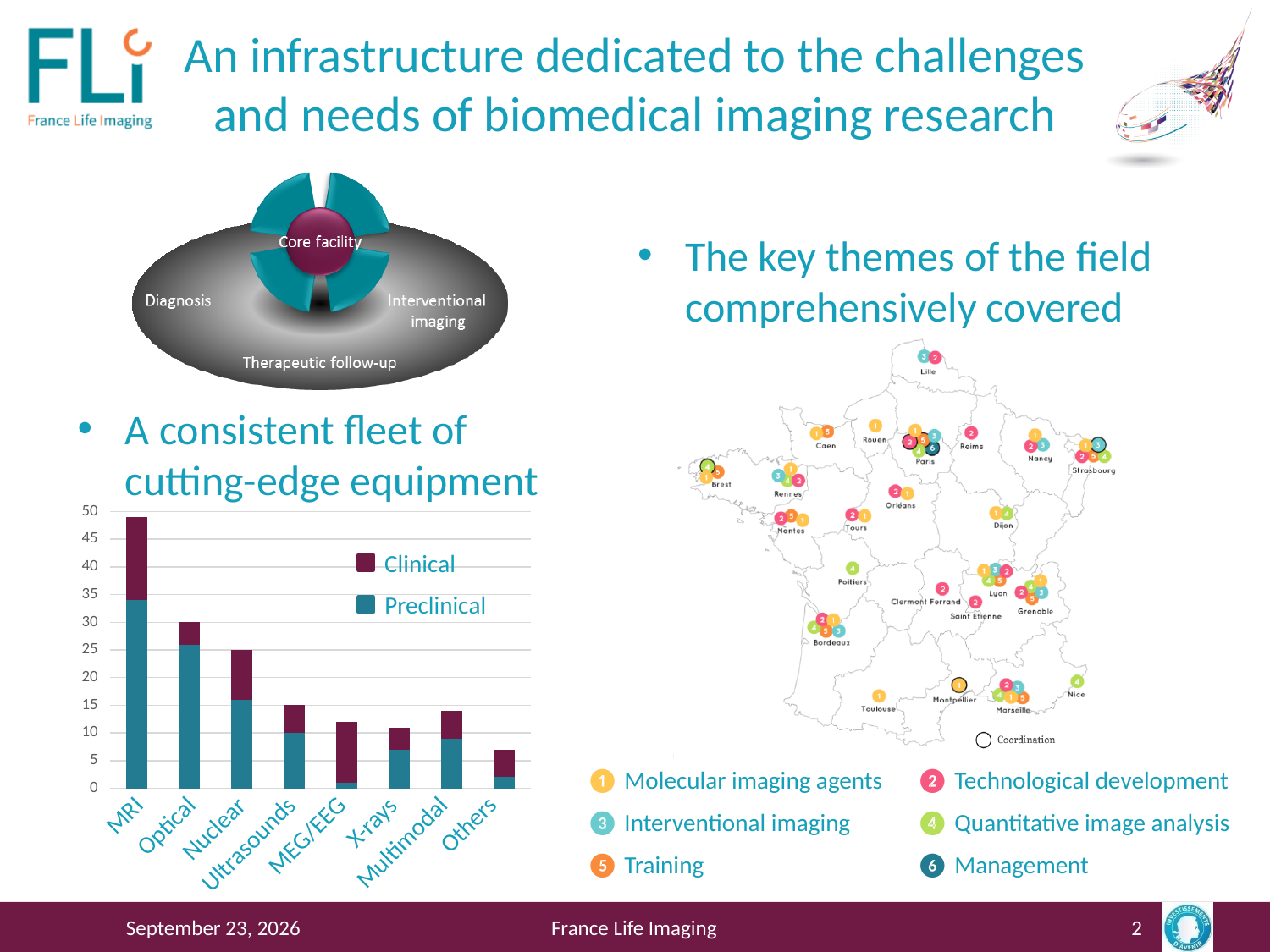
Is the total bar height for MRI greater or less than 45? greater Which category has the shortest bar in the bar chart? Others What kind of chart is shown on the left of the slide under 'A consistent fleet of cutting-edge equipment'? Bar chart Is the Preclinical value for MEG/EEG greater or less than 5? less Is the total bar height for Others greater or less than 10? less How many series does the legend of the bar chart list? 2 How many equipment categories are shown on the x axis of the bar chart? 8 Which has the taller total bar, Ultrasounds or Others? Ultrasounds Which has the taller total bar, Optical or Nuclear? Optical Which category has the tallest bar in the bar chart? MRI What are the two series named in the legend of the bar chart? Clinical and Preclinical